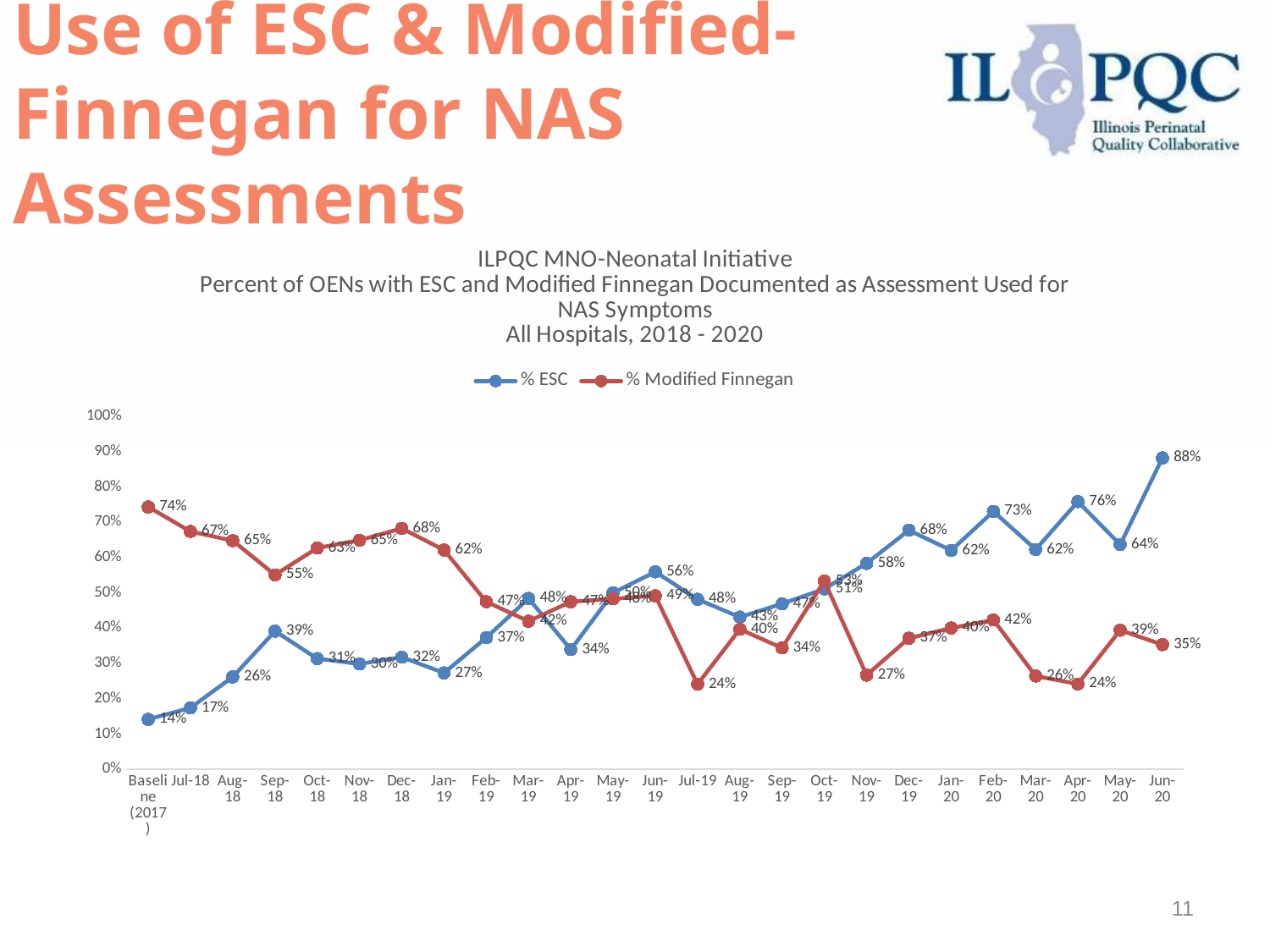
In Jun-20, what is the difference between % ESC and % Modified Finnegan? 53 percentage points How many time points are plotted along the x axis? 25 What is the % Modified Finnegan value at Baseline (2017)? 74% At which point is % Modified Finnegan highest? Baseline (2017) In which month is % ESC highest? Jun-20 Does % ESC generally rise or fall from Baseline (2017) to Jun-20? rise What is the % ESC value for Jun-20? 88% What is the % Modified Finnegan value for Jul-19? 24% In Sep-18, which series has the higher value, % ESC or % Modified Finnegan? % Modified Finnegan At which point is % ESC lowest? Baseline (2017) How many series does the legend list? 2 What type of chart is shown on the slide? line chart